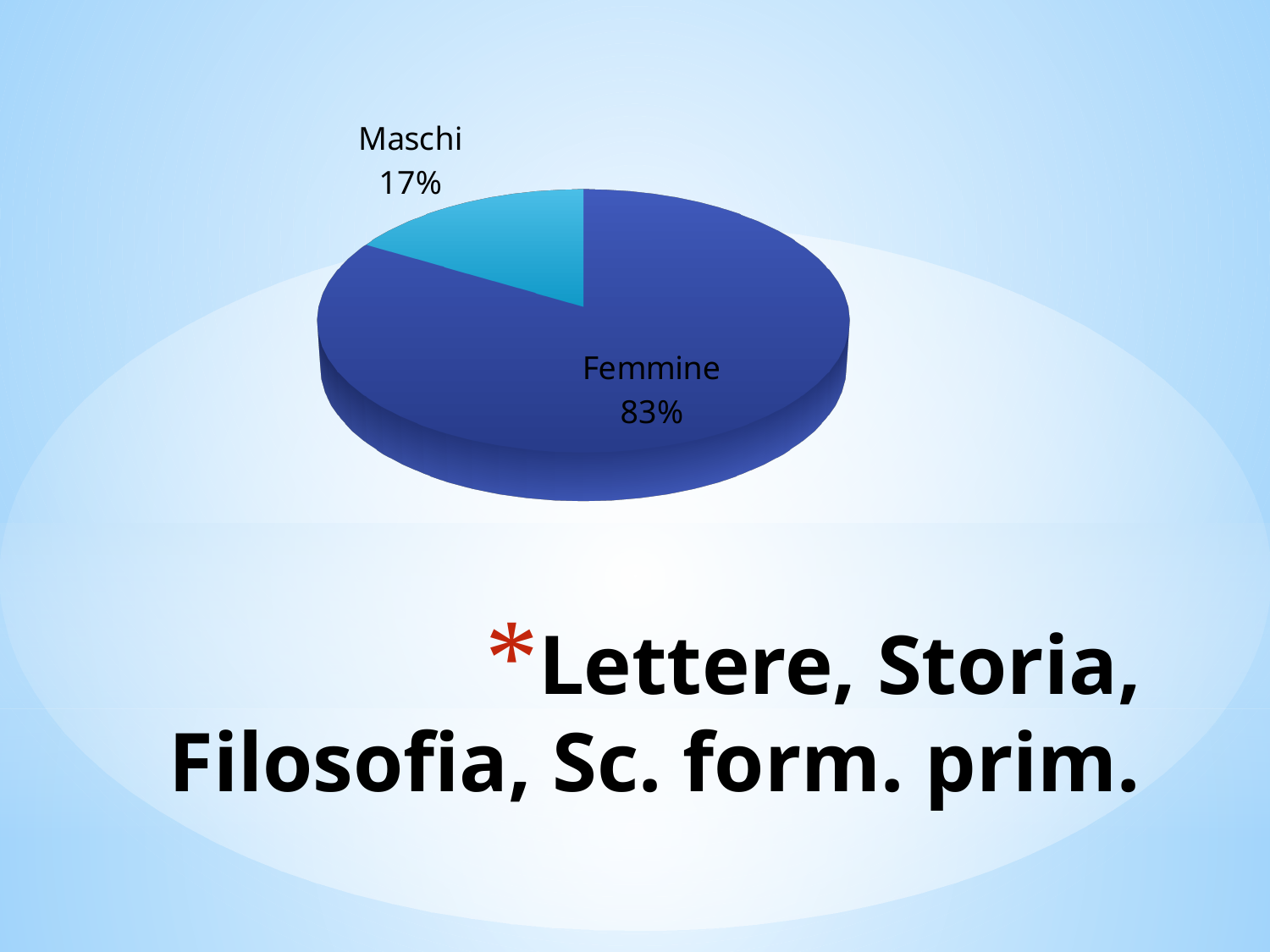
What colour is the Maschi slice of the pie? light blue What percentage of the pie is labelled Maschi? 17% What kind of chart is shown on the slide? pie chart What percentage of the pie is labelled Femmine? 83% What share of the pie does the Maschi slice represent? 17% Which slice of the pie is the smallest? Maschi Which is larger, the Maschi slice or the Femmine slice? Femmine What is the difference in percentage points between the Femmine and Maschi slices? 66 What colour is the Femmine slice of the pie? dark blue Which slice of the pie is the largest? Femmine How many slices does the pie chart have? 2